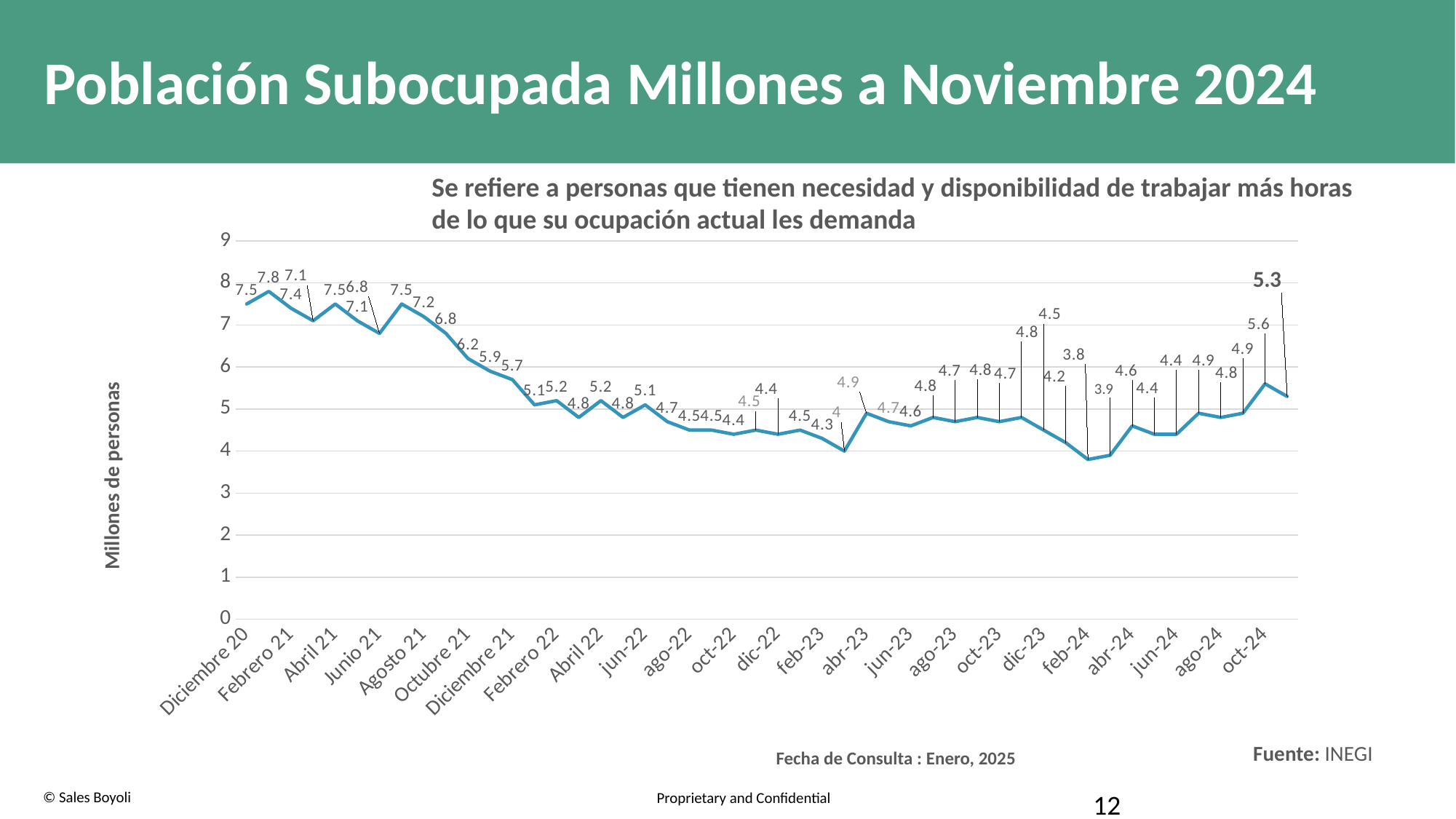
What is the value for oct-24? 5.6 What is the lowest value plotted on the chart? 3.8 What is the label of the vertical axis? Millones de personas What is the difference between the first value (7.5) and the last value (5.3) on the chart? 2.2 Is the value for feb-24 greater or less than 4? less What is the value for Diciembre 20, the first point on the chart? 7.5 Overall, do the values rise or fall from Diciembre 20 to the end of the chart? Fall What type of chart is shown on the slide? Line chart Which is larger, the value for Diciembre 20 or the value for oct-24? Diciembre 20 How many category labels are shown on the x axis? 24 What is the highest value plotted on the chart? 7.8 What is the value of the last data point on the chart (shown in bold)? 5.3